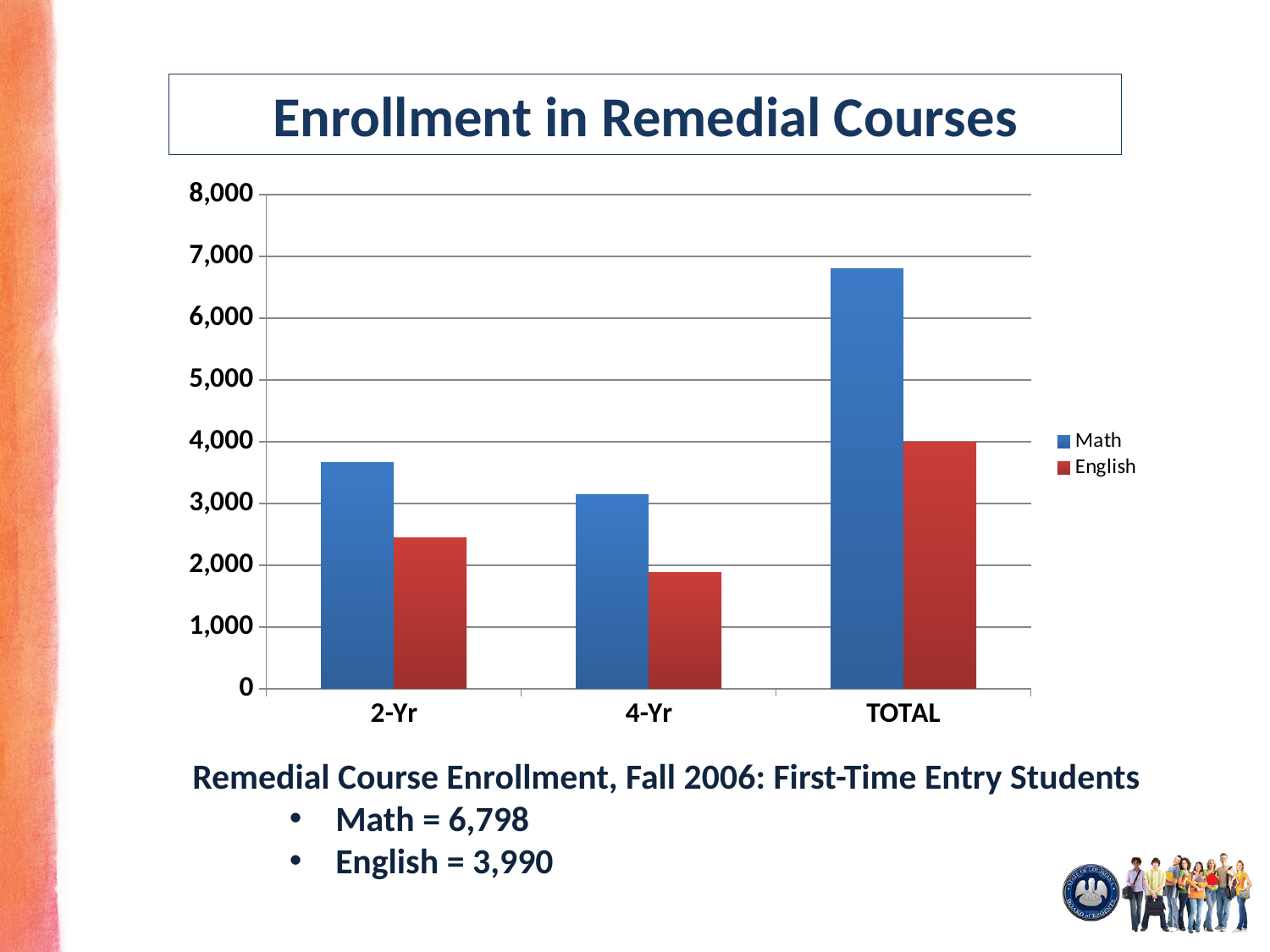
Is the Math value for 2-Yr greater or less than 3,000? greater What is the English enrollment value for the TOTAL category? 3,990 What kind of chart is shown on the slide? bar chart How many categories are shown on the x axis? 3 What is the Math enrollment value for the TOTAL category? 6,798 Which bar is the shortest in the chart? English, 4-Yr What is the difference between the TOTAL Math and TOTAL English enrollment values? 2,808 Which bar is the tallest in the chart? Math, TOTAL How many series does the legend list? 2 Which colour represents the English series in the legend? red Which is larger, the Math value for 2-Yr or the Math value for 4-Yr? 2-Yr Is the English value for 2-Yr greater or less than 3,000? less